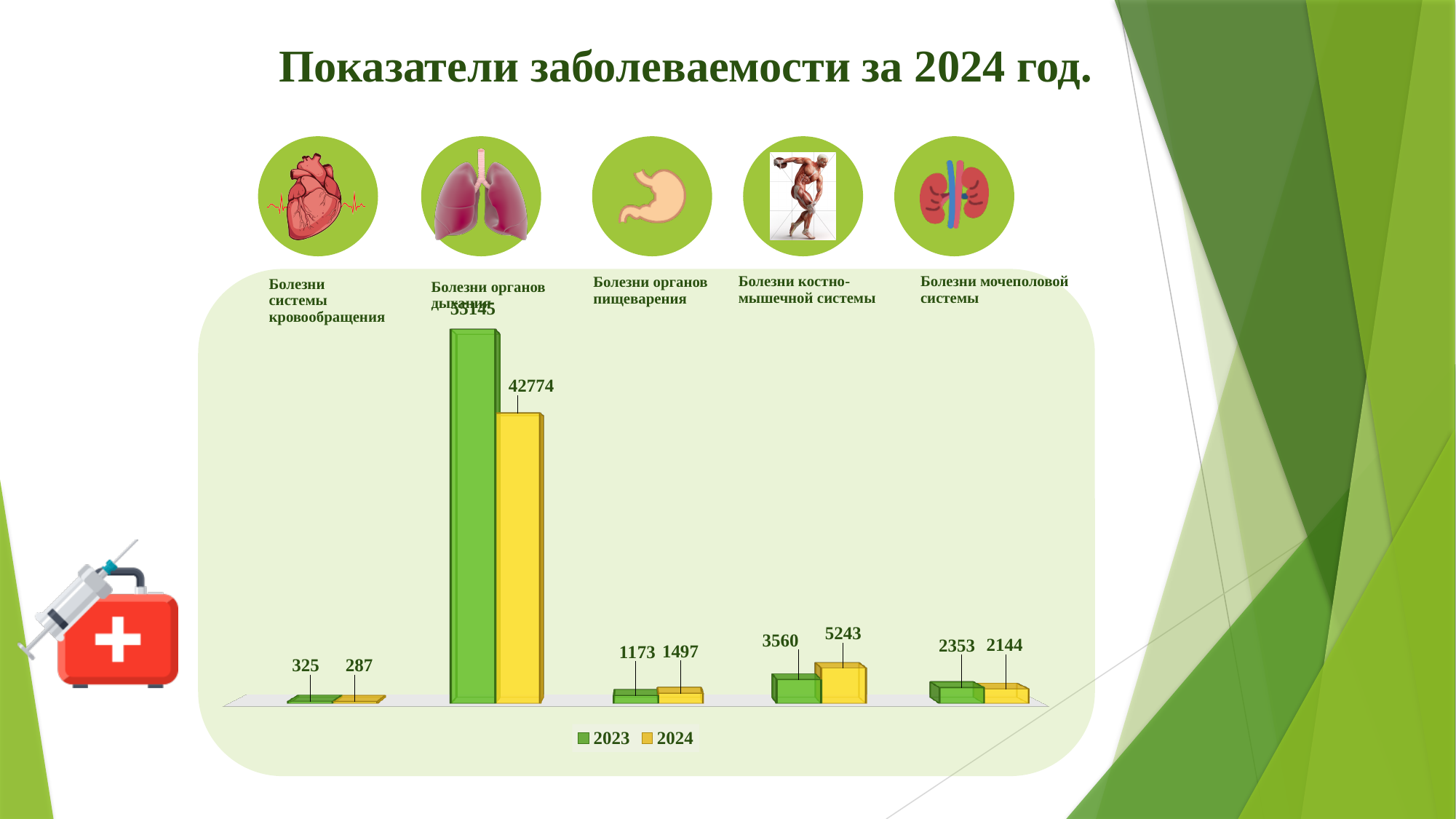
Which category has the lowest 2023 value? Болезни системы кровообращения What kind of chart is shown on the slide? bar chart Which colour represents the 2024 series in the legend? yellow What is the 2023 value for Болезни мочеполовой системы? 2353 How many series does the legend list? 2 What is the 2024 value for Болезни органов дыхания? 42774 What is the difference between the 2024 and 2023 values for Болезни органов пищеварения? 324 How many disease categories are plotted in the chart? 5 Which category has the highest 2024 value? Болезни органов дыхания What is the 2024 value for Болезни костно-мышечной системы? 5243 For Болезни мочеполовой системы, which year has the larger value, 2023 or 2024? 2023 What is the 2023 value for Болезни системы кровообращения? 325